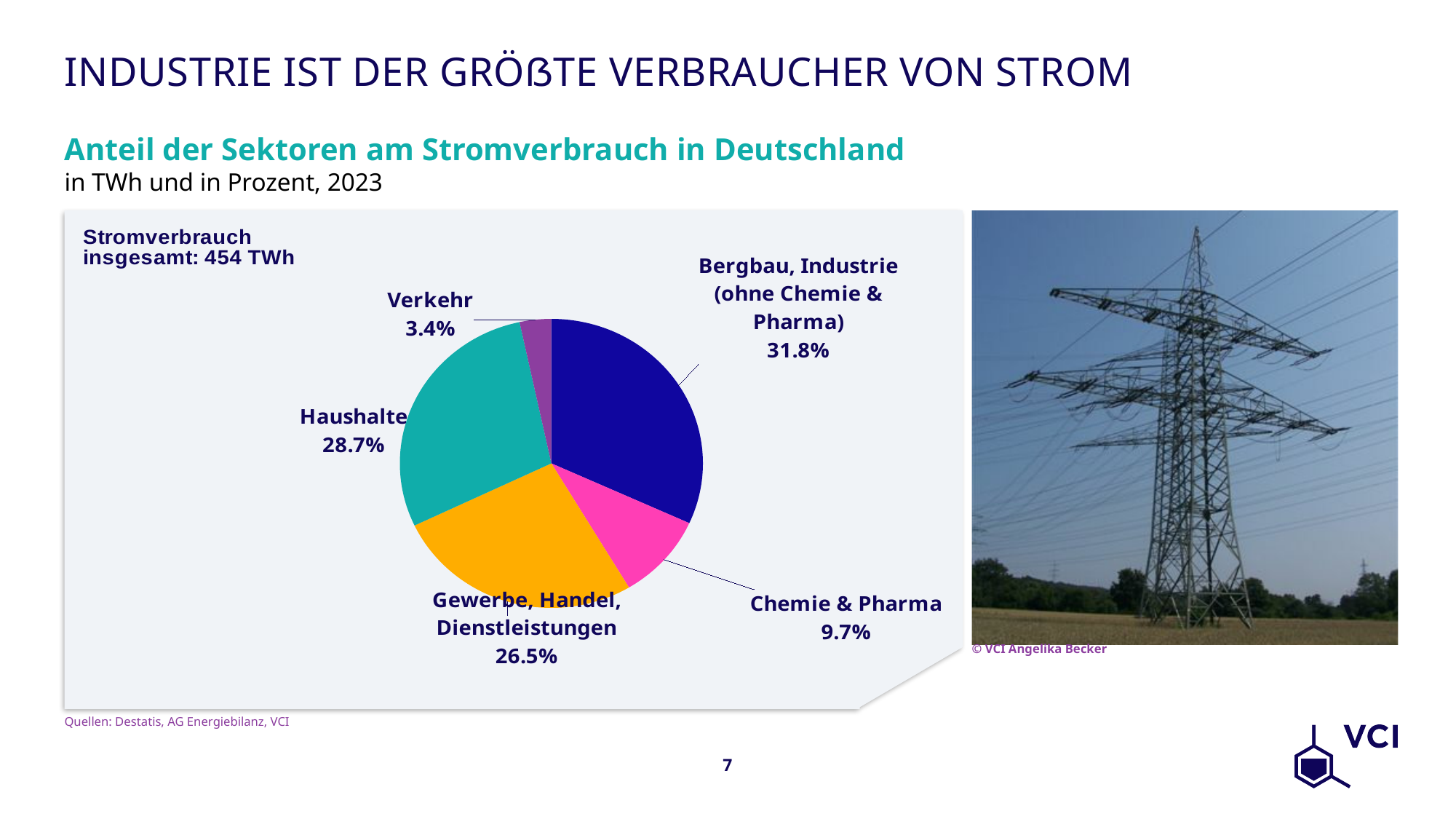
Which has a larger share: Chemie & Pharma or Verkehr? Chemie & Pharma Which sector has the largest share of electricity consumption? Bergbau, Industrie (ohne Chemie & Pharma) How many sectors are shown in the pie chart? 5 What colour is the Haushalte slice? Teal What kind of chart is shown on the slide? Pie chart What is the difference in percentage points between Haushalte and Gewerbe, Handel, Dienstleistungen? 2.2 percentage points What share is shown for Chemie & Pharma? 9.7% What share is shown for Gewerbe, Handel, Dienstleistungen? 26.5% What share is shown for Verkehr? 3.4% What is the total electricity consumption stated on the chart? 454 TWh Which sector has the smallest share of electricity consumption? Verkehr What share of electricity consumption does the Haushalte slice represent? 28.7%